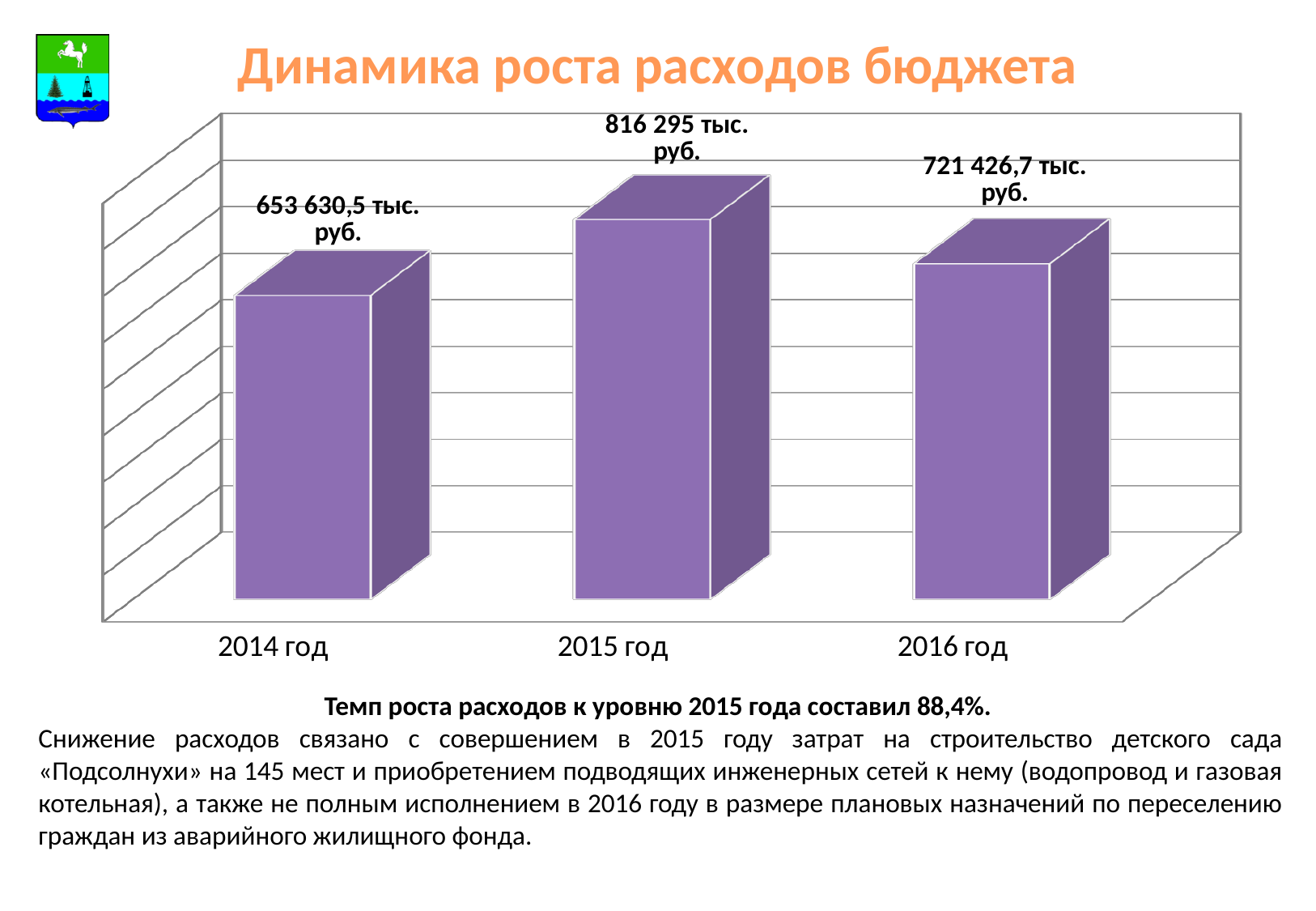
Which year has the highest value? 2015 год Which year has the lowest value? 2014 год Which is larger, the value for 2014 год or the value for 2016 год? 2016 год What kind of chart is shown on the slide? Bar chart What is the value for 2015 год? 816 295 тыс. руб. How many years are shown on the chart? 3 What is the value for 2016 год? 721 426,7 тыс. руб. What is the title of the chart? Динамика роста расходов бюджета What is the difference between the values for 2016 год and 2014 год? 67 796,2 тыс. руб. What is the difference between the values for 2015 год and 2016 год? 94 868,3 тыс. руб. What is the value for 2014 год? 653 630,5 тыс. руб. What is the difference between the values for 2015 год and 2014 год? 162 664,5 тыс. руб.